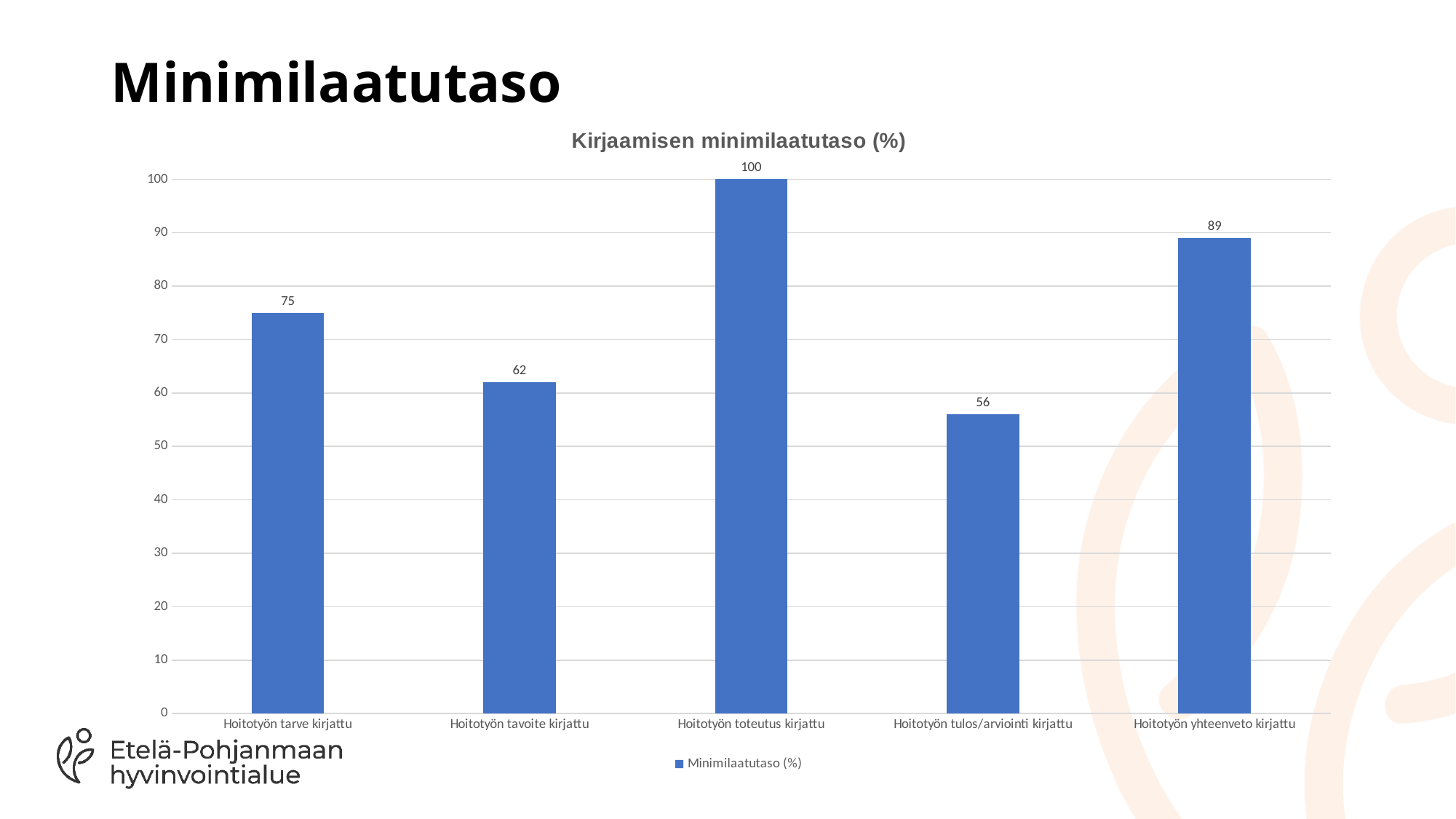
What is the value for Hoitotyön tarve kirjattu? 75 What is the value for Hoitotyön tavoite kirjattu? 62 Is the value for Hoitotyön yhteenveto kirjattu greater or less than 80? greater Which category has the highest value? Hoitotyön toteutus kirjattu Which is larger, the value for Hoitotyön tarve kirjattu or Hoitotyön tavoite kirjattu? Hoitotyön tarve kirjattu What is the title of the chart? Kirjaamisen minimilaatutaso (%) What is the difference between the values for Hoitotyön toteutus kirjattu and Hoitotyön tulos/arviointi kirjattu? 44 What is the value for Hoitotyön yhteenveto kirjattu? 89 What is the value for Hoitotyön tulos/arviointi kirjattu? 56 How many categories are shown on the x axis? 5 What kind of chart is shown on the slide? bar chart Which category has the lowest value? Hoitotyön tulos/arviointi kirjattu